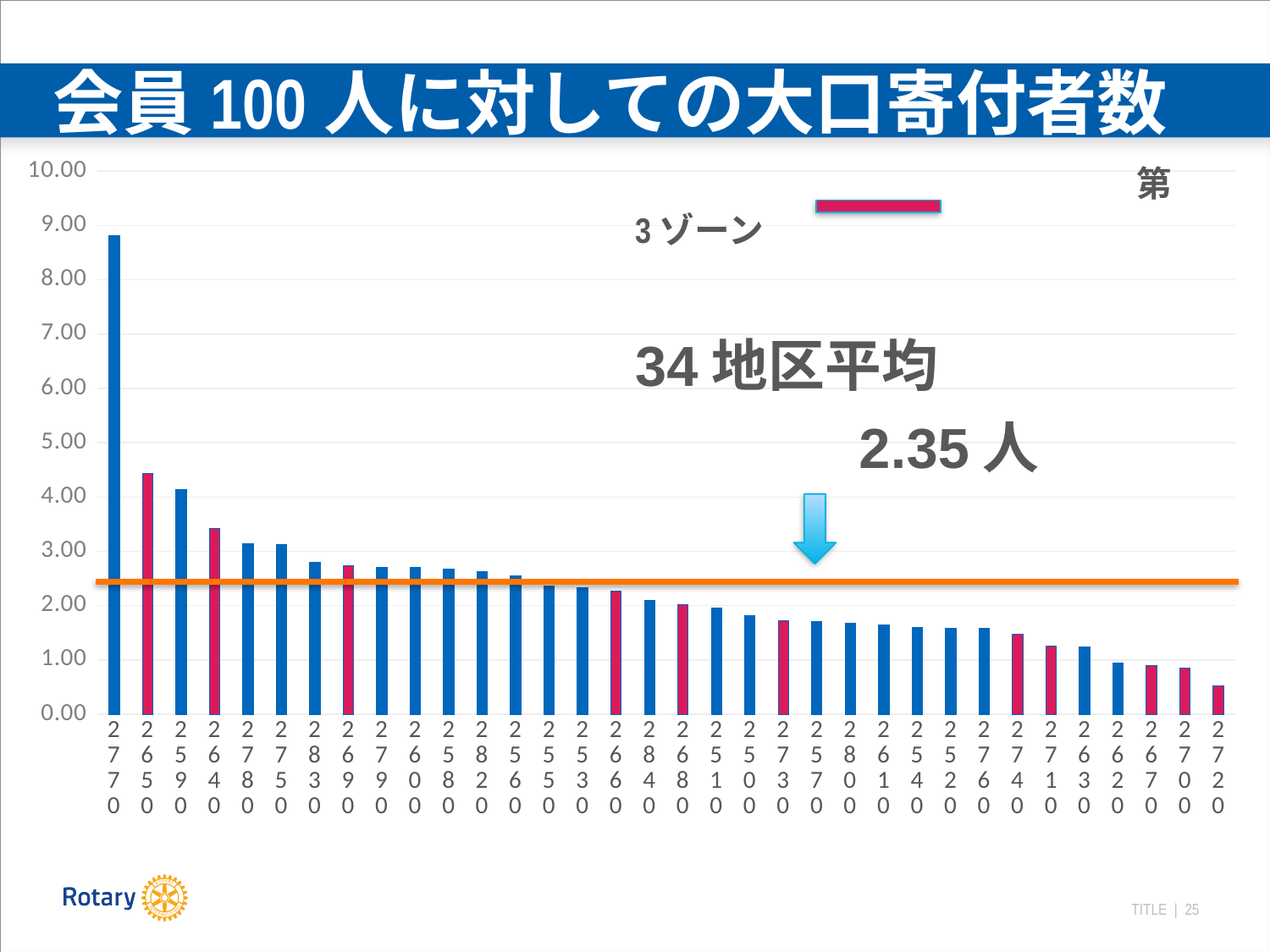
Is the value for district 2650 greater or less than 4.00? greater Is the value for district 2770 greater or less than 8.00? greater Is the value for district 2720 greater or less than 1.00? less What kind of chart is shown on the slide? bar chart What is the 34-district average (34地区平均) shown on the slide? 2.35人 What is the title of the chart on the slide? 会員100人に対しての大口寄付者数 Do the bar values rise or fall from left to right along the x axis? fall Which district has the lowest number of major donors per 100 members? 2720 How many districts (bars) are plotted in the chart? 34 Which district has a larger value, 2650 or 2590? 2650 Which district has the highest number of major donors per 100 members? 2770